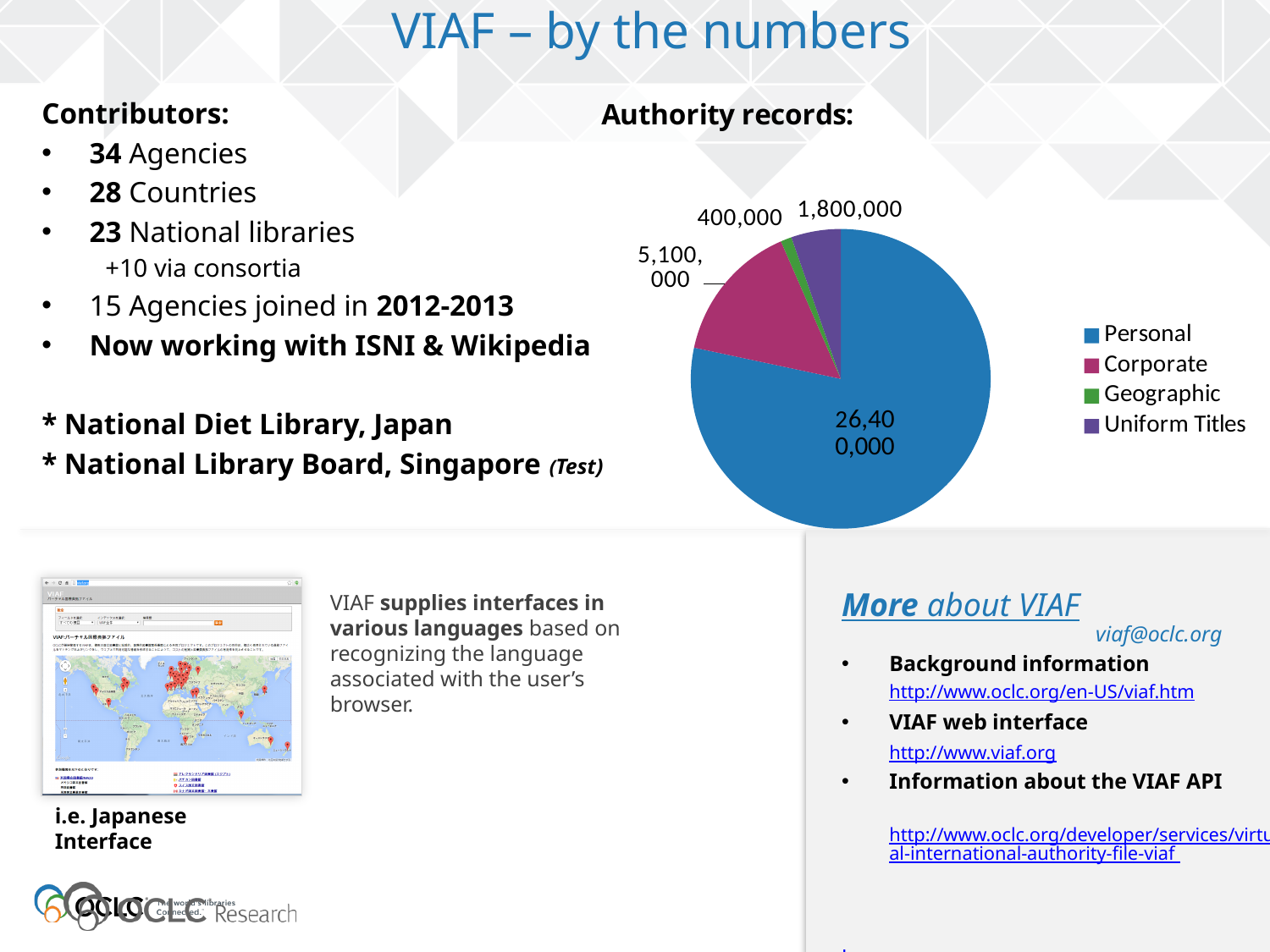
In the Authority records pie chart, what is the value for Corporate? 5,100,000 What colour is the Corporate slice in the Authority records pie chart? magenta In the Authority records pie chart, how many records are there for Personal? 26,400,000 In the Authority records pie chart, how many more records are there for Personal than for Corporate? 21,300,000 In the Authority records pie chart, which is larger: Corporate or Uniform Titles? Corporate Which category has the largest slice in the Authority records pie chart? Personal What type of chart is shown under "Authority records"? pie chart In the Authority records pie chart, what is the value for Geographic? 400,000 In the Authority records pie chart, what is the difference between Uniform Titles and Geographic? 1,400,000 How many categories does the legend of the Authority records pie chart list? 4 In the Authority records pie chart, what is the value for Uniform Titles? 1,800,000 Which category has the smallest slice in the Authority records pie chart? Geographic